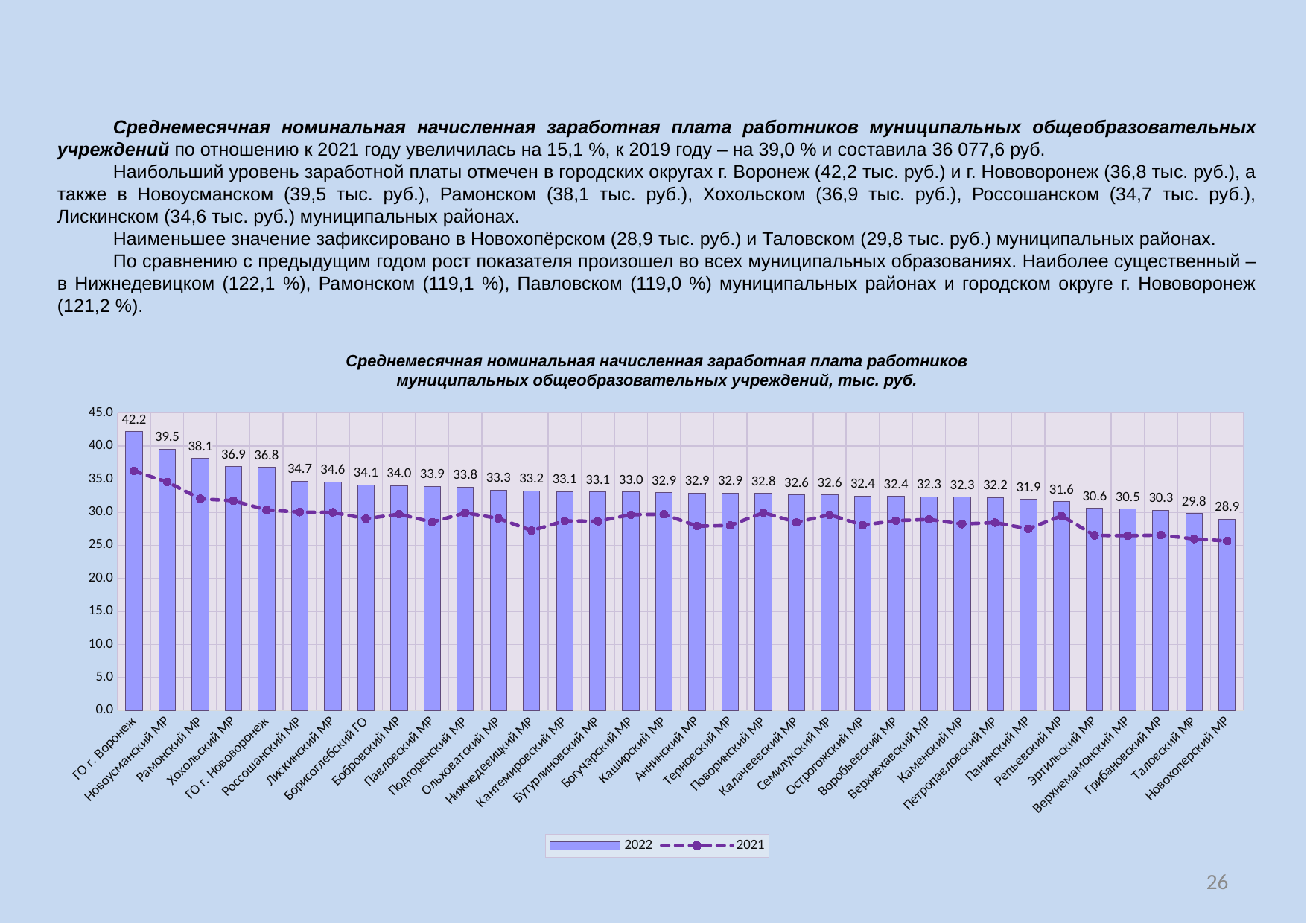
Which category has the highest 2022 value? ГО г. Воронеж What is the 2022 value for Таловский МР? 29.8 How many categories are shown on the x axis? 34 How many series does the legend list? 2 Is the 2021 value for ГО г. Воронеж greater or less than 35.0? greater Which has the larger 2022 value, Новоусманский МР or Хохольский МР? Новоусманский МР What is the difference between the 2022 values for ГО г. Воронеж and Новохоперский МР? 13.3 Is the 2021 value for Новохоперский МР greater or less than 30.0? less Which category has the lowest 2022 value? Новохоперский МР What kind of chart is shown? Bar chart with a line series Do the 2022 bar values rise or fall from left to right along the x axis? fall What is the 2022 value for Рамонский МР? 38.1